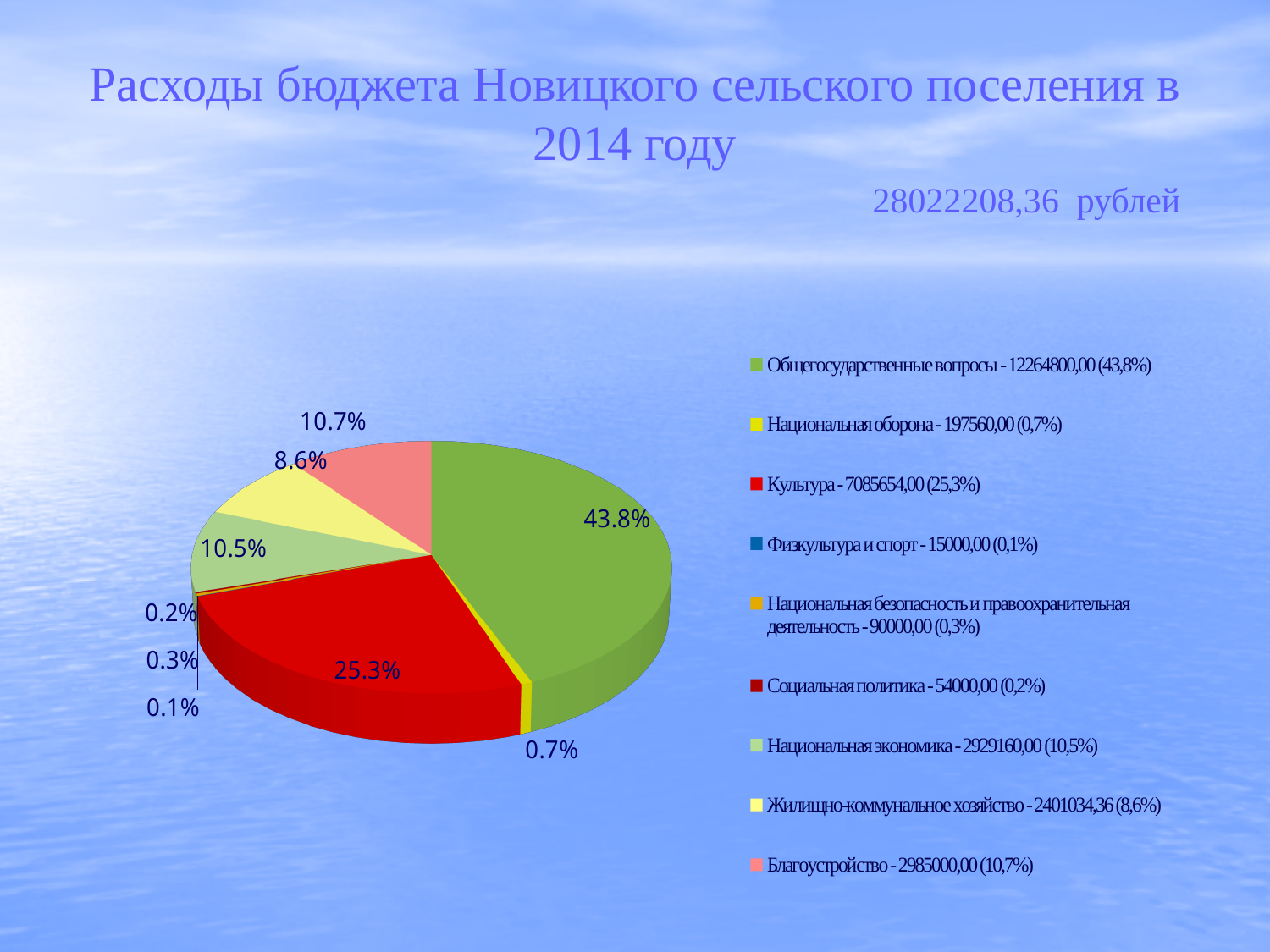
What share of the pie does Национальная оборона account for? 0.7% According to the legend, what is the amount for Социальная политика? 54000,00 What kind of chart is shown on the slide? pie chart Which category has the largest share of the pie? Общегосударственные вопросы What is the difference in percentage points between the shares of Общегосударственные вопросы and Культура? 18.5 What share of the pie does Культура account for? 25.3% What is the title of the slide? Расходы бюджета Новицкого сельского поселения в 2014 году According to the legend, what is the amount for Благоустройство? 2985000,00 Which category has the smallest share of the pie? Физкультура и спорт What total amount in rubles is shown under the title? 28022208,36 рублей Which has the larger share: Национальная экономика or Жилищно-коммунальное хозяйство? Национальная экономика How many categories does the pie chart have? 9